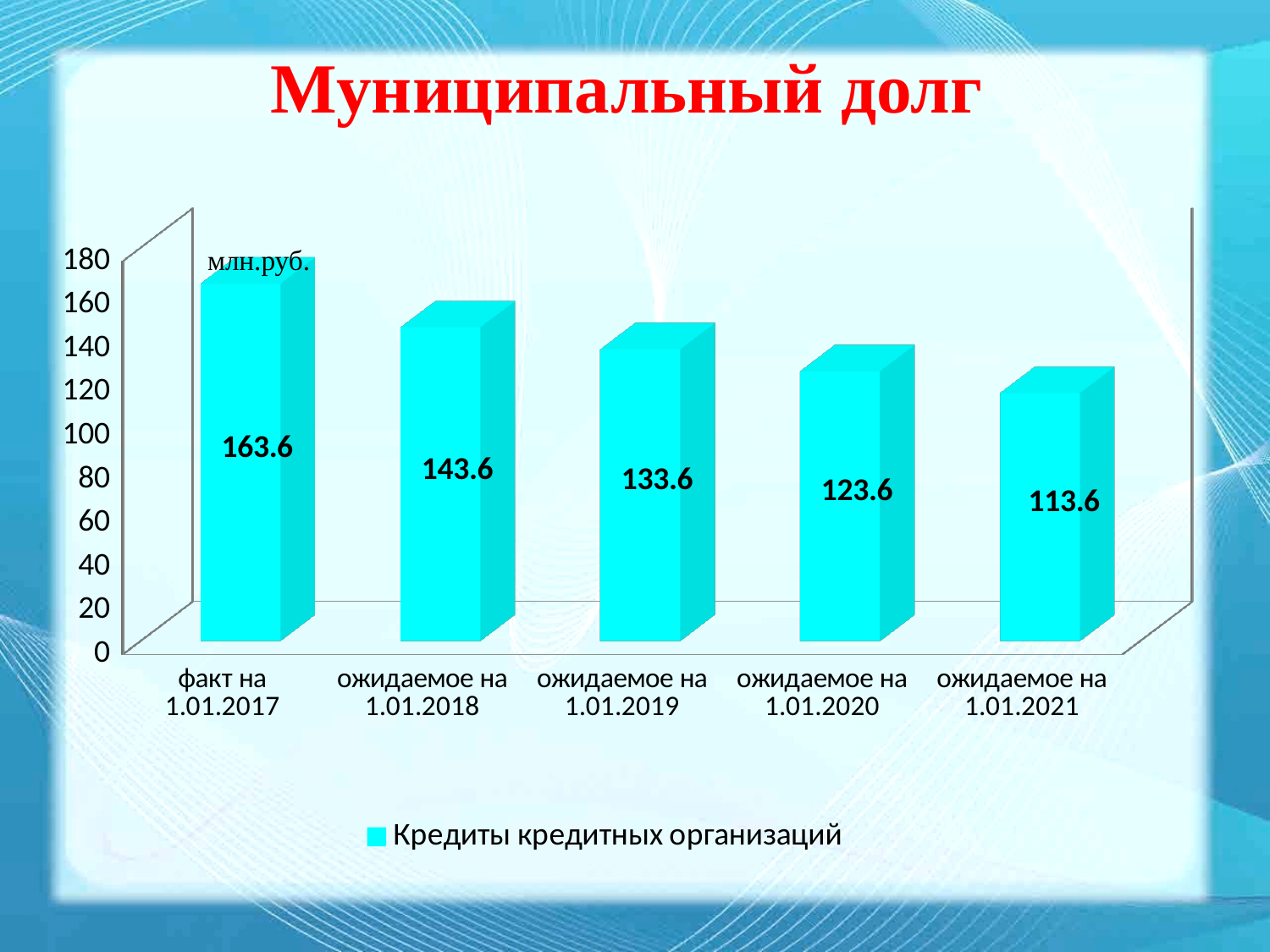
Do the values rise or fall from left to right along the x axis? fall What is the difference between the values for "ожидаемое на 1.01.2018" and "ожидаемое на 1.01.2020"? 20 What is the difference between the values for "факт на 1.01.2017" and "ожидаемое на 1.01.2021"? 50 What is the value for "факт на 1.01.2017"? 163.6 What kind of chart is shown on the slide? bar chart What is the value for "ожидаемое на 1.01.2021"? 113.6 What is the value for "ожидаемое на 1.01.2019"? 133.6 Which category has the lowest value? ожидаемое на 1.01.2021 Which category has the highest value? факт на 1.01.2017 Which is larger, the value for "ожидаемое на 1.01.2018" or "ожидаемое на 1.01.2020"? ожидаемое на 1.01.2018 How many series does the legend list? 1 How many categories are shown on the x axis? 5